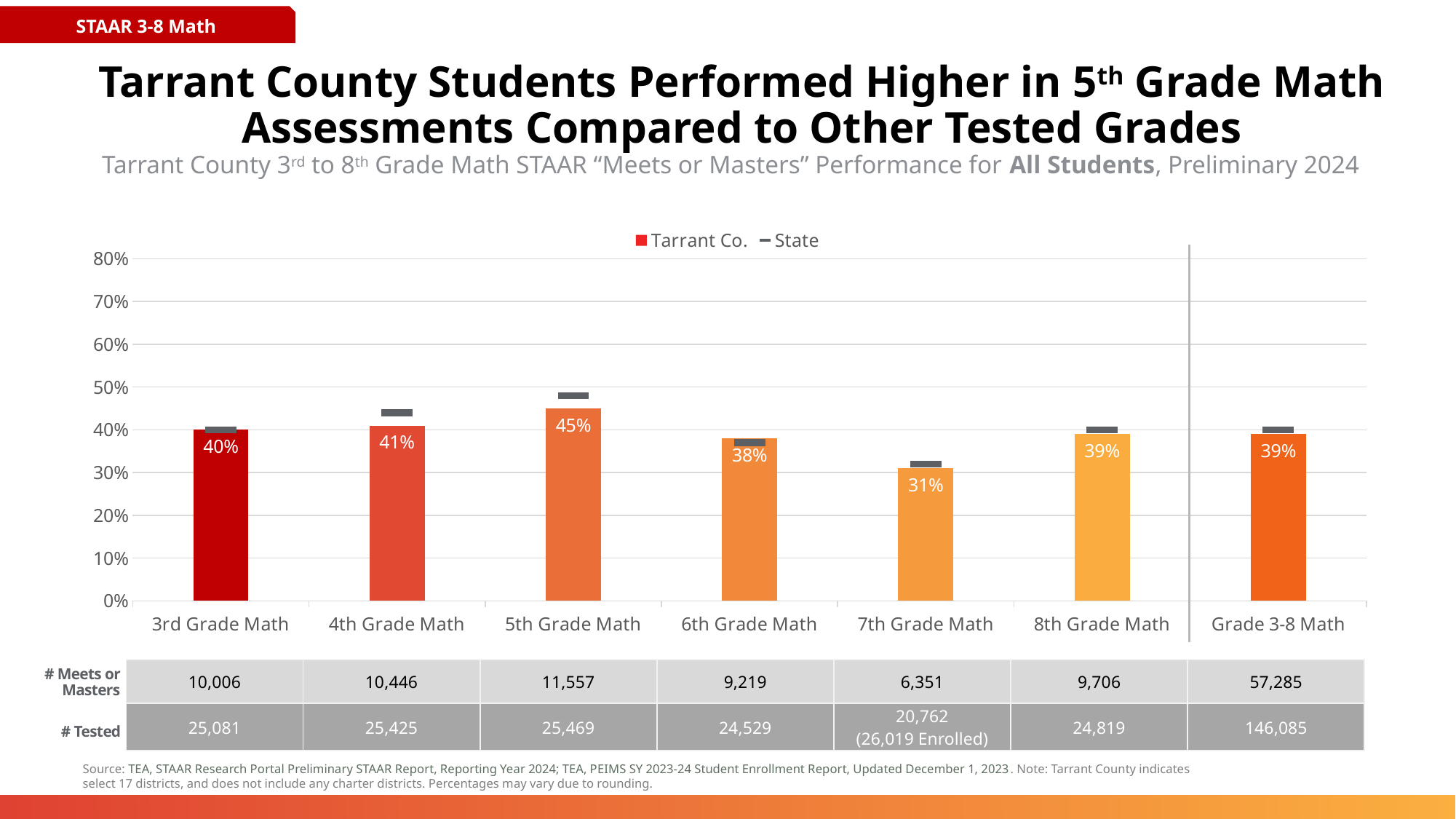
Which has a larger Tarrant Co. value, 4th Grade Math or 6th Grade Math? 4th Grade Math Which grade has the lowest Tarrant Co. value? 7th Grade Math What is the difference between the Tarrant Co. values for 5th Grade Math and 7th Grade Math? 14 percentage points Is the State value for 5th Grade Math greater or less than 40%? greater What is the Tarrant Co. value for Grade 3-8 Math? 39% What is the Tarrant Co. value for 5th Grade Math? 45% How many series does the legend list? 2 Is the State value for 7th Grade Math greater or less than 40%? less Which grade has the highest Tarrant Co. value? 5th Grade Math What kind of chart is shown on the slide? bar chart How many categories are shown on the x axis of the chart? 7 What is the Tarrant Co. value for 7th Grade Math? 31%